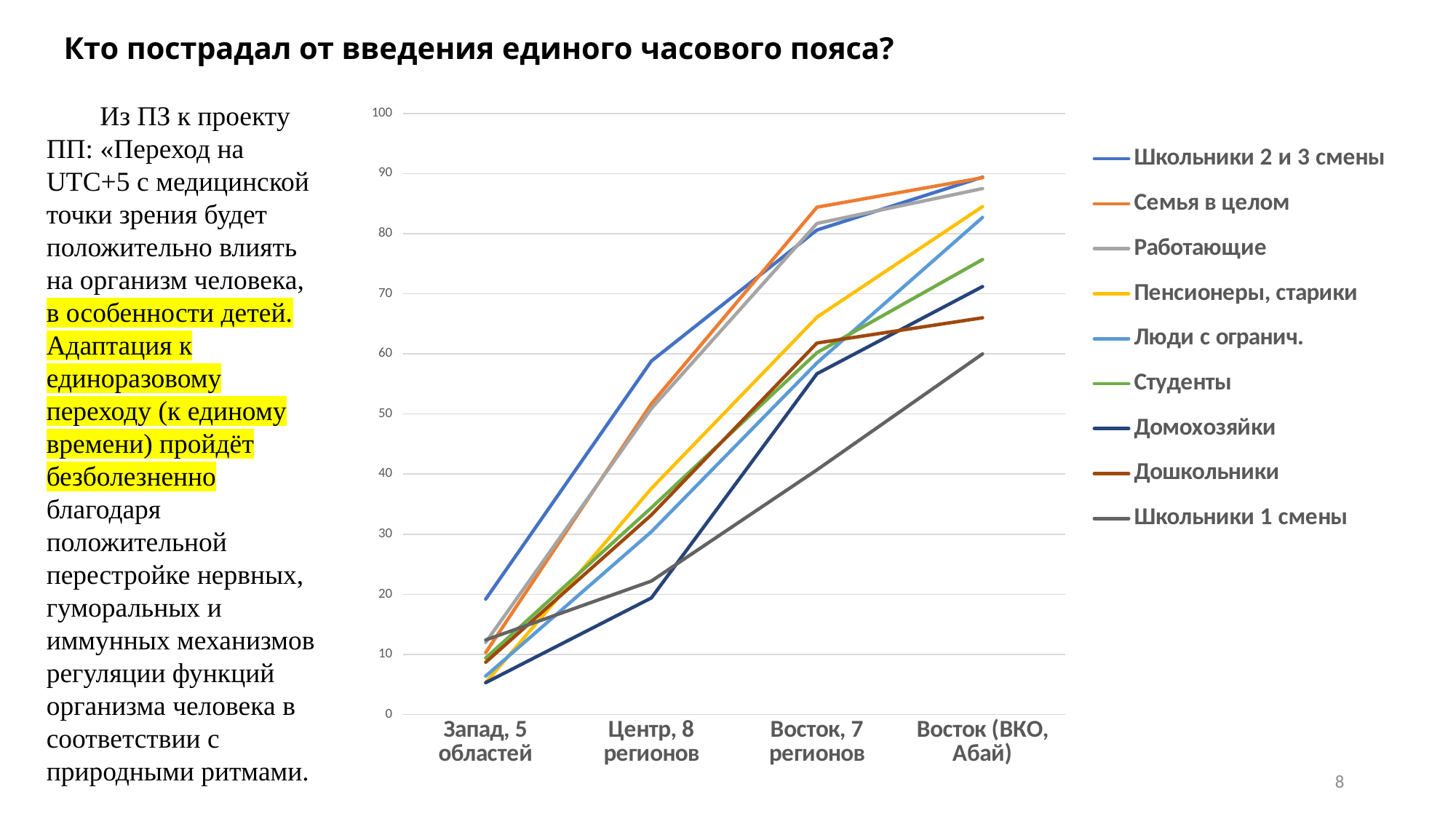
Which series has the highest value at Запад, 5 областей? Школьники 2 и 3 смены What colour is the line for Семья в целом? Orange Do the values for Школьники 1 смены rise or fall from Запад, 5 областей to Восток (ВКО, Абай)? Rise How many categories are shown along the x axis? 4 Which series has the lowest value at Восток (ВКО, Абай)? Школьники 1 смены At Восток (ВКО, Абай), which is larger: Пенсионеры, старики or Студенты? Пенсионеры, старики Is the value for Школьники 2 и 3 смены at Запад, 5 областей greater or less than 10? greater Is the value for Школьники 1 смены at Восток (ВКО, Абай) greater or less than 70? less What kind of chart is shown on the slide? Line chart Is the value for Домохозяйки at Центр, 8 регионов greater or less than 30? less Which series has the highest value at Центр, 8 регионов? Школьники 2 и 3 смены How many series does the legend list? 9